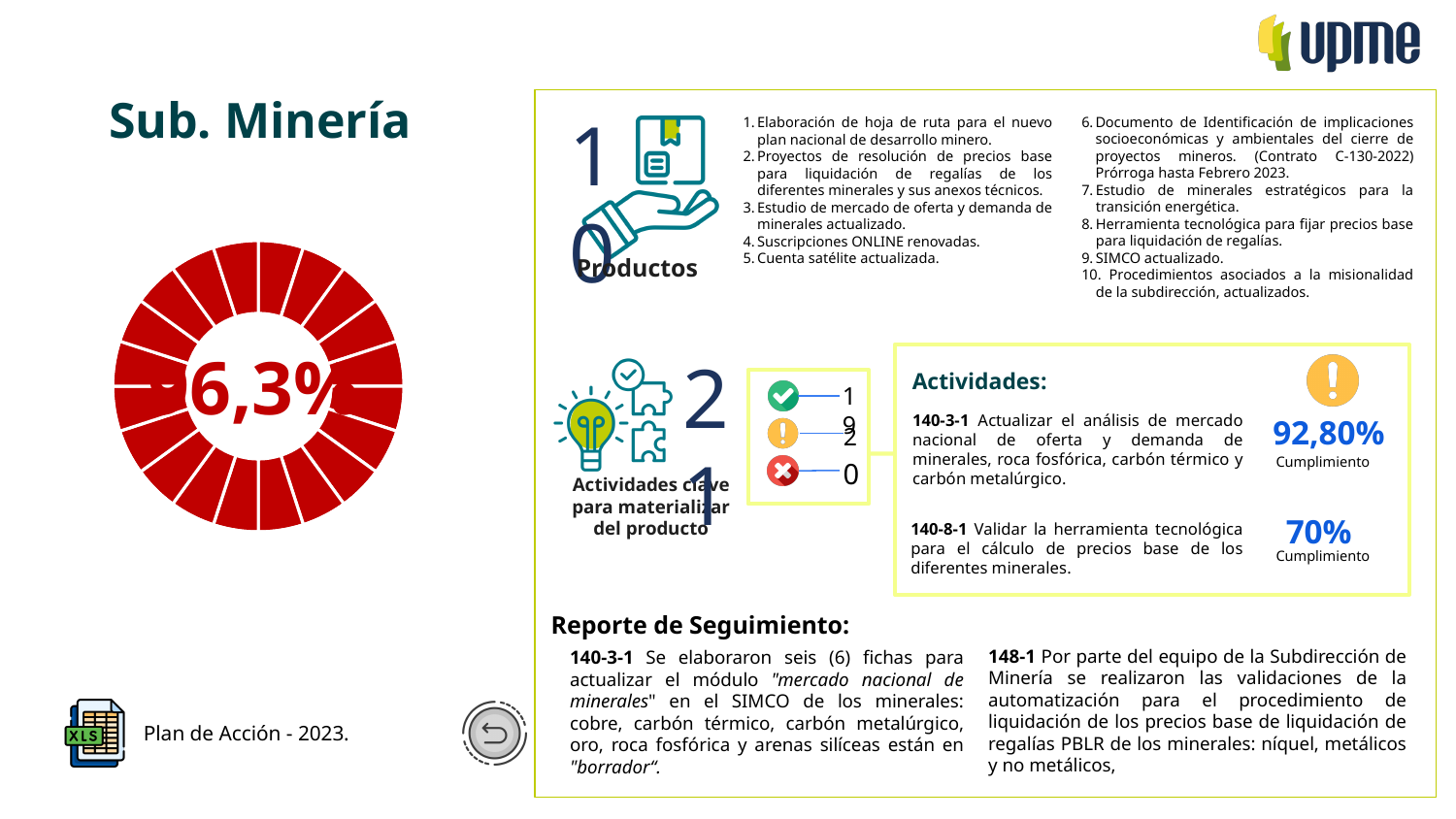
What percentage value is printed in the centre of the donut chart on the left of the slide? 96,3% Is the value printed in the centre of the donut chart greater or less than 10%? greater What colour are the segments of the donut chart on the left of the slide? red What kind of chart is shown on the left side of the slide under the title 'Sub. Minería'? pie chart (donut)